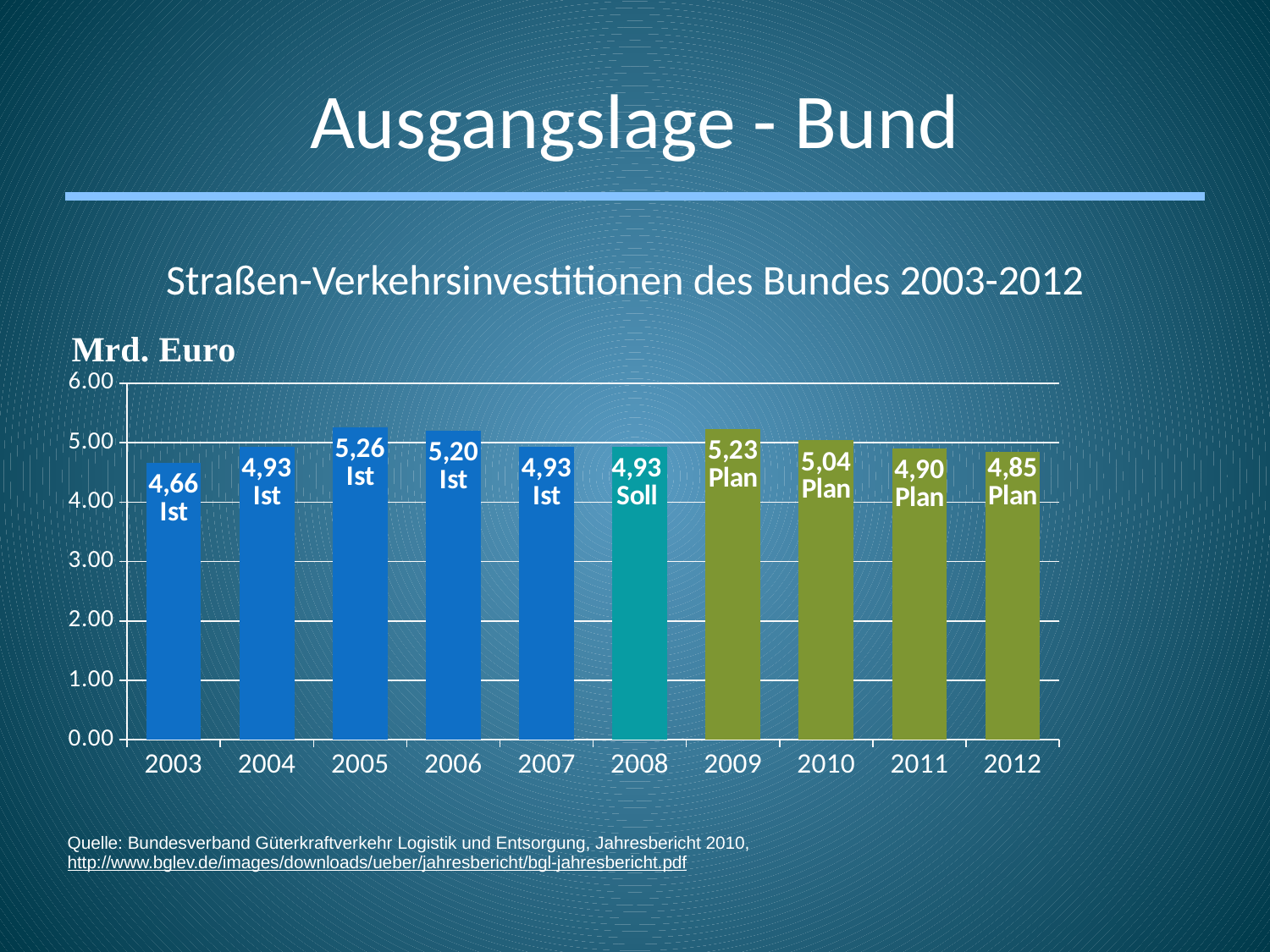
What is the difference between the values for 2005 and 2003? 0,60 What is the value for 2005? 5,26 Which year has the highest value? 2005 What is the value for 2003? 4,66 What is the value for 2012? 4,85 What unit is shown above the y axis of the chart? Mrd. Euro Is the value for 2006 greater or less than 5.00? greater How many years are shown on the x axis? 10 What kind of chart is shown on the slide? bar chart Which year has the lowest value? 2003 What is the value for 2010? 5,04 Which is larger, the value for 2009 or the value for 2011? 2009